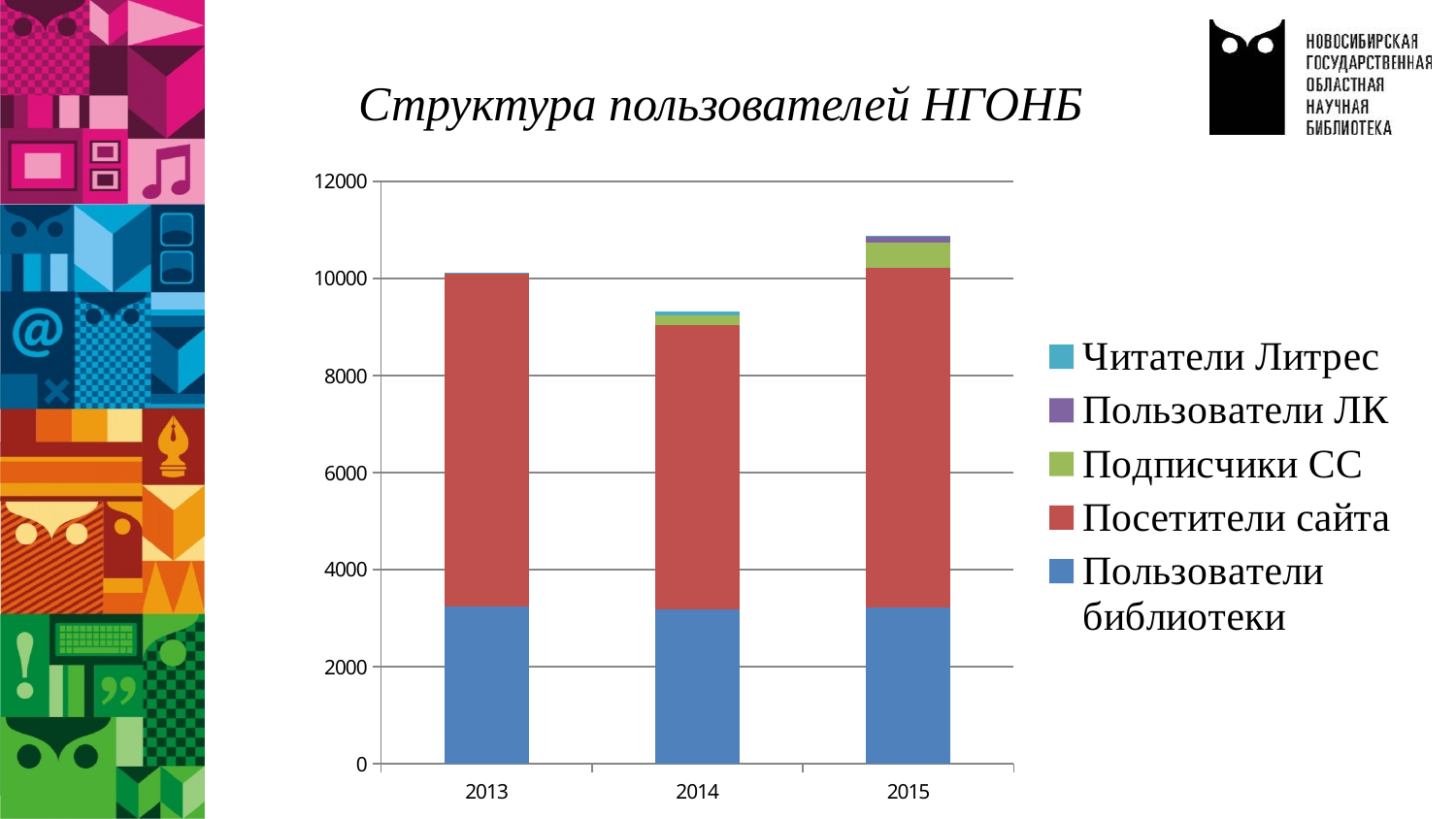
Is the value for Пользователи библиотеки in 2013 greater or less than 4000? less How many series does the legend list? 5 Is the total stacked bar for 2015 greater or less than 10000? greater Which year has the shortest stacked bar? 2014 Is the value for Пользователи библиотеки in 2015 greater or less than 2000? greater What is the title of the chart? Структура пользователей НГОНБ Which year has the tallest stacked bar? 2015 Which series is shown in blue at the bottom of each bar? Пользователи библиотеки What kind of chart is shown on the slide? Stacked bar chart How many years are shown on the x axis? 3 Which year has the larger total stacked bar, 2013 or 2014? 2013